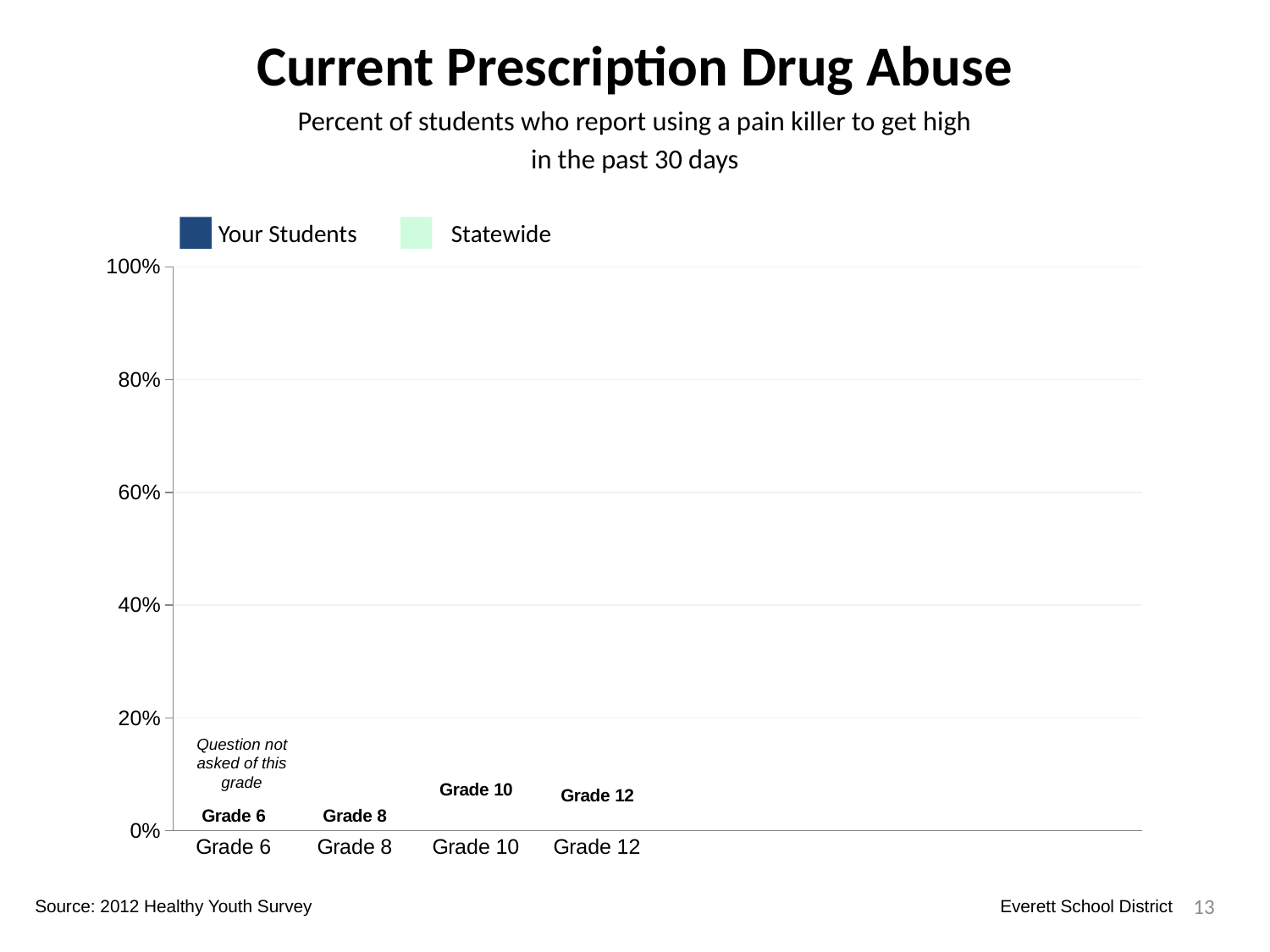
What is the title of the chart on the slide? Current Prescription Drug Abuse What is the highest value shown on the chart's y axis? 100% Which grade category carries the note "Question not asked of this grade"? Grade 6 What are the two series named in the chart's legend? Your Students and Statewide How many grade categories are shown on the x axis of the chart? 4 What is the lowest value shown on the chart's y axis? 0% What kind of chart is shown on the slide? bar chart How many series does the chart's legend list? 2